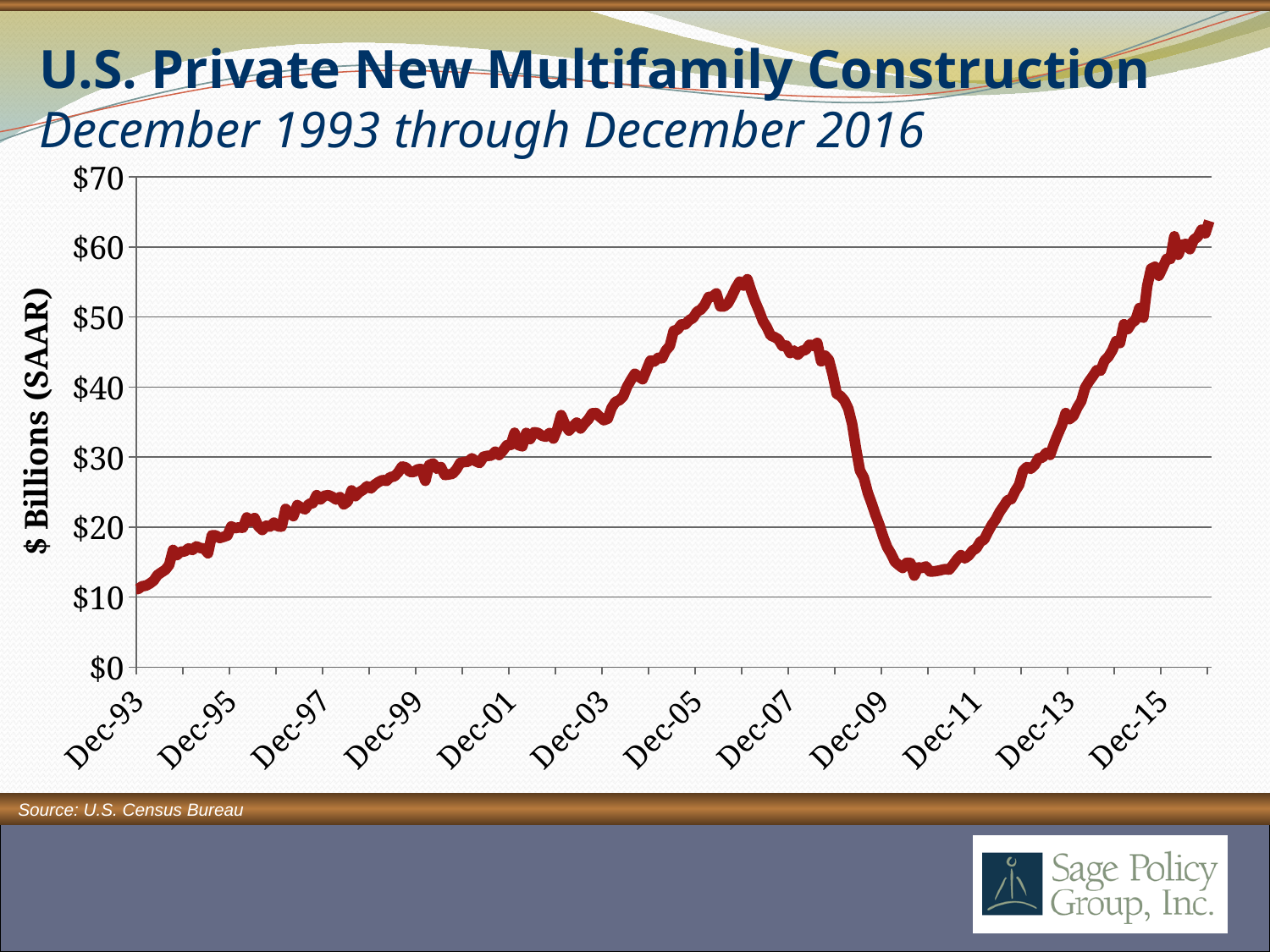
What kind of chart is shown on the slide? line chart Does the line rise or fall between Dec-07 and Dec-09? fall Does the line rise or fall between Dec-11 and Dec-15? rise Is the value for Dec-11 greater or less than $20? less Is the value for Dec-15 greater or less than $50? greater Is the value for Dec-07 greater or less than $40? greater What is the label on the vertical axis? $ Billions (SAAR) How many date labels are shown on the horizontal axis? 12 What is the title of the chart? U.S. Private New Multifamily Construction Which is larger, the value for Dec-05 or the value for Dec-09? Dec-05